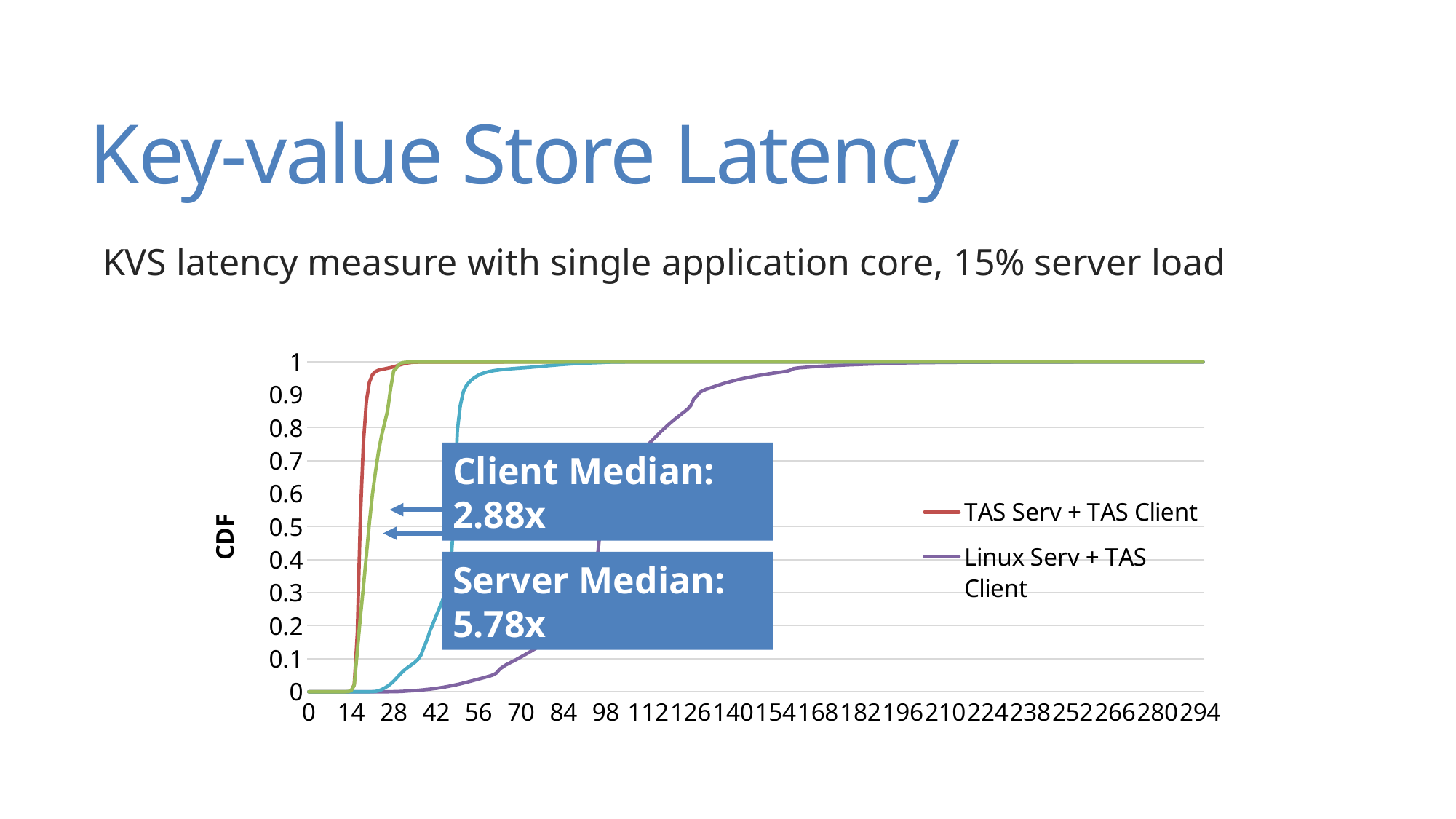
Is the CDF value of the TAS Serv + TAS Client line at x = 28 greater or less than 0.9? greater What is the largest tick value shown on the x axis? 294 Which series does the red line represent according to the legend? TAS Serv + TAS Client Do the CDF lines rise or fall as the x axis increases? rise What is the label on the y axis of the chart? CDF What is the Server Median speedup stated in the annotation on the chart? 5.78x What is the Client Median speedup stated in the annotation on the chart? 2.88x At x = 28, which line has the higher CDF value: TAS Serv + TAS Client or Linux Serv + TAS Client? TAS Serv + TAS Client How many series does the chart's legend list? 2 Is the CDF value of the Linux Serv + TAS Client line at x = 56 greater or less than 0.1? less What kind of chart is shown on the slide? line chart Is the CDF value of the Linux Serv + TAS Client line at x = 126 greater or less than 0.8? greater